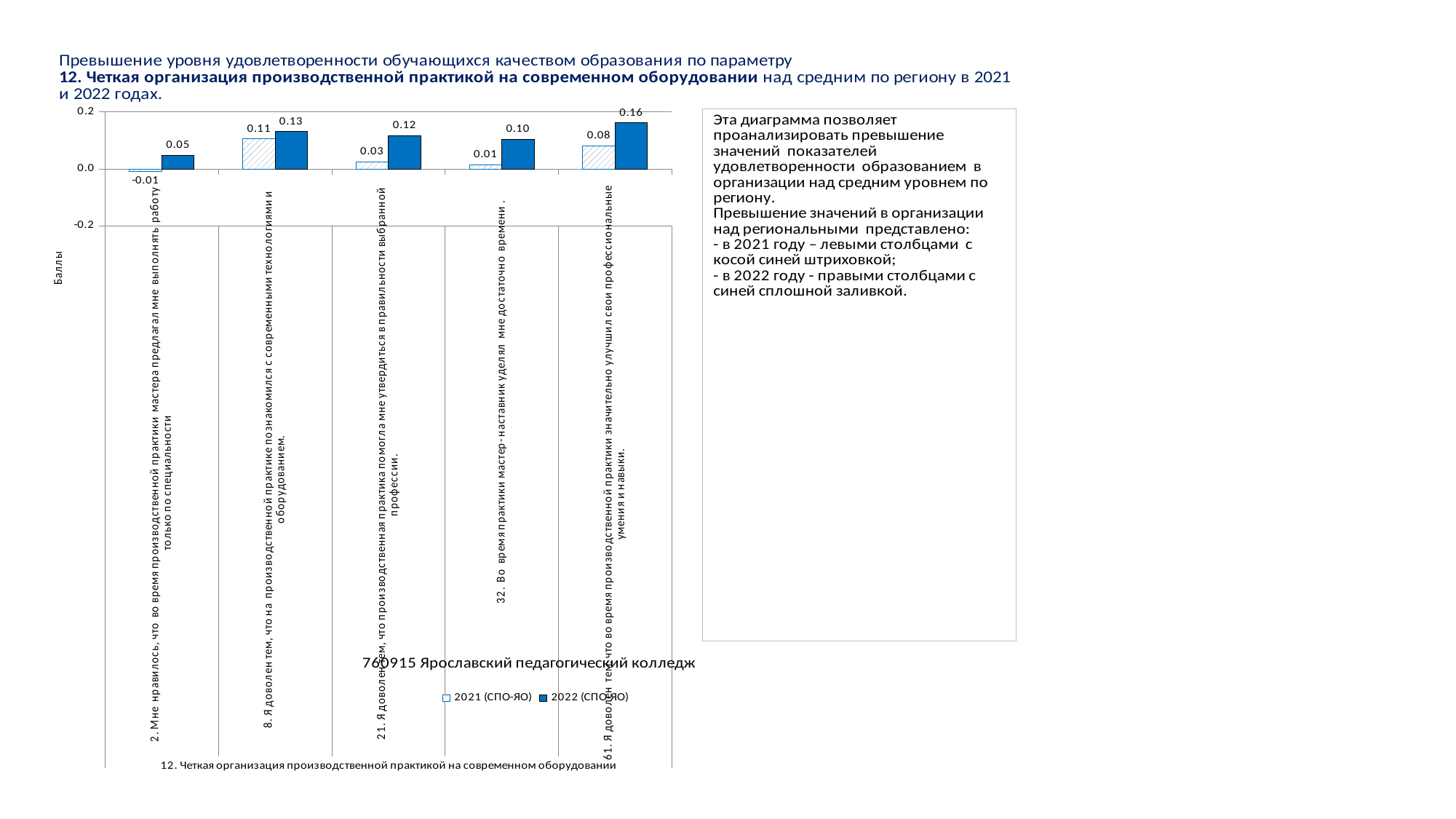
How many categories are shown on the x axis of the chart? 5 Which category has the highest value for 2022 (СПО-ЯО)? 61. Я доволен тем, что во время производственной практики значительно улучшил свои профессиональные умения и навыки. What is the label of the vertical axis of the chart? Баллы What is the value for 2021 (СПО-ЯО) for the category "2. Мне нравилось, что во время производственной практики мастера предлагал мне выполнять работу только по специальности"? -0.01 For the category "8. Я доволен тем, что на производственной практике познакомился с современными технологиями и оборудованием.", which series has the larger value, 2021 (СПО-ЯО) or 2022 (СПО-ЯО)? 2022 (СПО-ЯО) What is the value for 2021 (СПО-ЯО) for the category "8. Я доволен тем, что на производственной практике познакомился с современными технологиями и оборудованием."? 0.11 What is the value for 2022 (СПО-ЯО) for the category "32. Во время практики мастер-наставник уделял мне достаточно времени."? 0.10 What type of chart is shown on the slide? Bar chart What is the value for 2022 (СПО-ЯО) for the category "61. Я доволен тем, что во время производственной практики значительно улучшил свои профессиональные умения и навыки."? 0.16 How many series does the chart legend list? 2 What is the difference between the 2022 (СПО-ЯО) and 2021 (СПО-ЯО) values for the category "21. Я доволен тем, что производственная практика помогла мне утвердиться в правильности выбранной профессии."? 0.09 Which category has the lowest value for 2021 (СПО-ЯО)? 2. Мне нравилось, что во время производственной практики мастера предлагал мне выполнять работу только по специальности